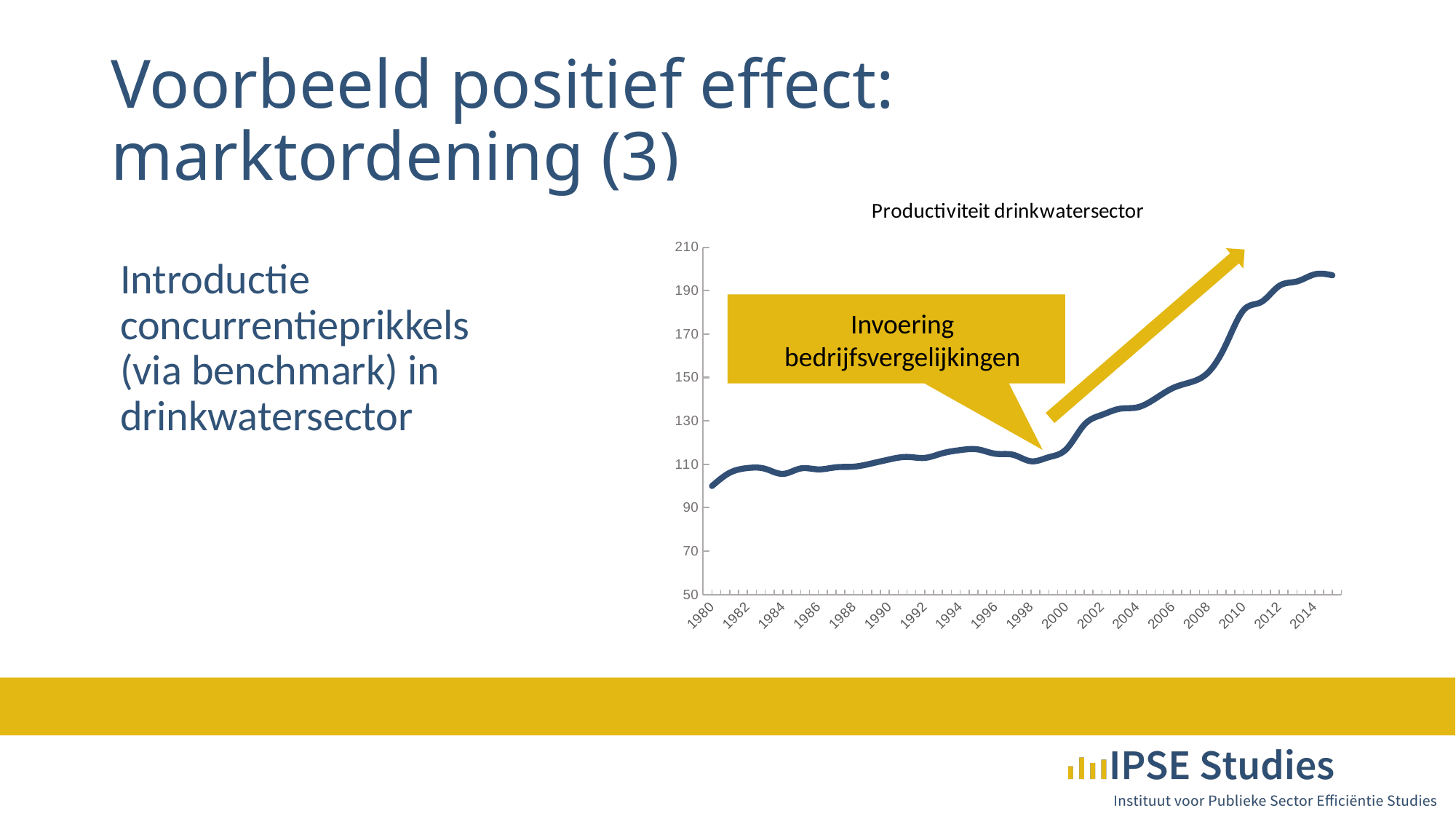
What kind of chart is shown on the slide? line chart Is the value for 2010 greater or less than 170? greater Is the value for 2014 greater or less than 190? greater Is the value for 2000 greater or less than 130? less What is the title of the chart? Productiviteit drinkwatersector Which year has the larger value, 2000 or 2010? 2010 Do the values in the chart generally rise or fall from 1980 to 2014? rise What is the highest value shown on the vertical axis? 210 What text is shown in the yellow callout on the chart? Invoering bedrijfsvergelijkingen Which year has the lowest value in the chart? 1980